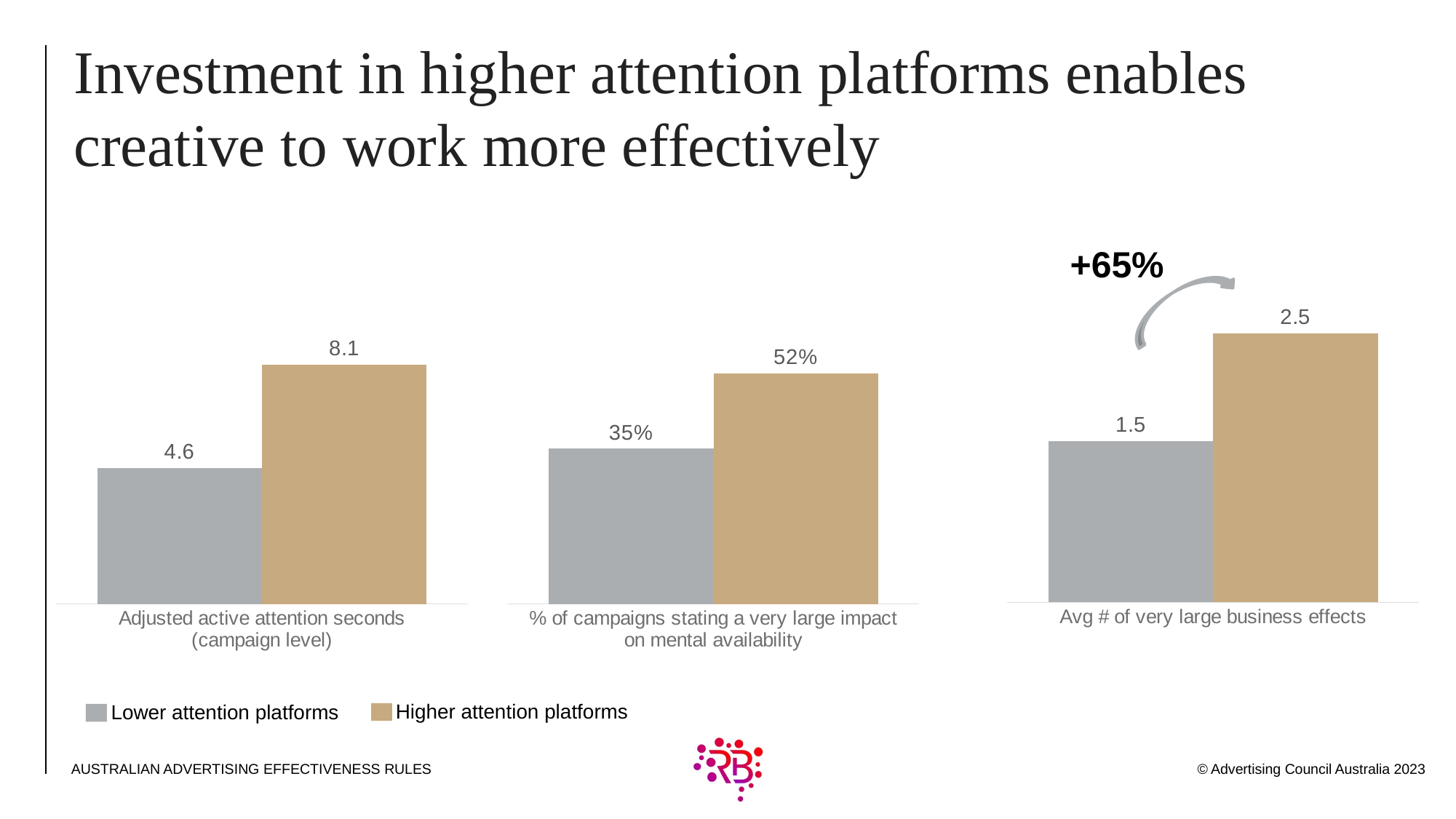
In the '% of campaigns stating a very large impact on mental availability' chart, what is the value for Higher attention platforms? 52% In the 'Adjusted active attention seconds (campaign level)' chart, what is the value for Lower attention platforms? 4.6 In the '% of campaigns stating a very large impact on mental availability' chart, what is the value for Lower attention platforms? 35% In the 'Avg # of very large business effects' chart, which series has the lower value? Lower attention platforms In the '% of campaigns stating a very large impact on mental availability' chart, which series has the larger value, Lower attention platforms or Higher attention platforms? Higher attention platforms In the 'Adjusted active attention seconds (campaign level)' chart, what is the value for Higher attention platforms? 8.1 In the 'Avg # of very large business effects' chart, what is the value for Higher attention platforms? 2.5 In the 'Avg # of very large business effects' chart, what is the difference between Higher attention platforms and Lower attention platforms? 1.0 How many series does the legend list? 2 In the 'Adjusted active attention seconds (campaign level)' chart, what is the difference between Higher attention platforms and Lower attention platforms? 3.5 What percentage increase is annotated above the 'Avg # of very large business effects' chart? +65% What kind of chart is the 'Adjusted active attention seconds (campaign level)' chart? Bar chart